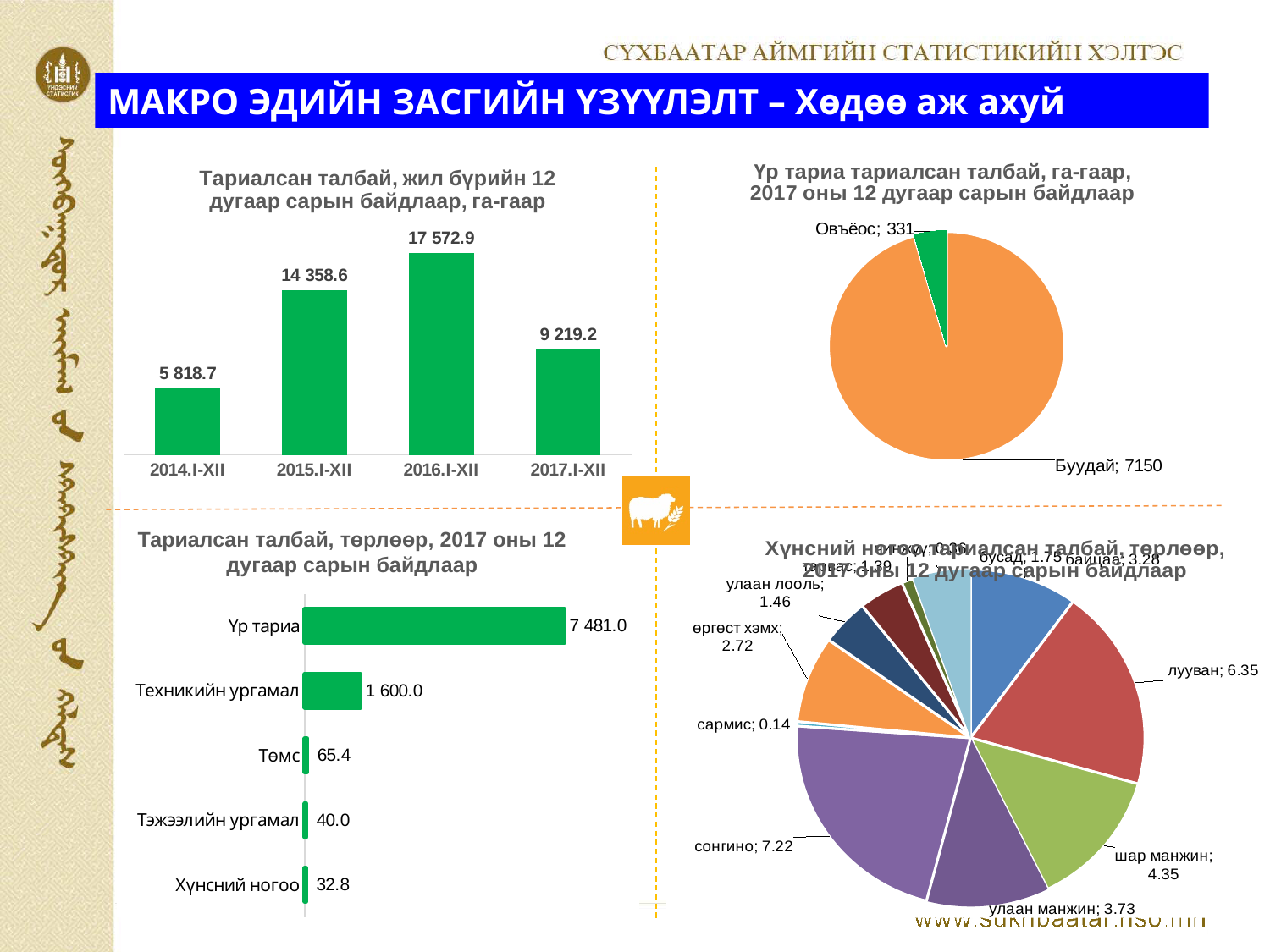
In the bottom-left bar chart 'Тариалсан талбай, төрлөөр, 2017 оны 12 дугаар сарын байдлаар', what is the difference between Төмс and Тэжээлийн ургамал? 25.4 In the bottom-left bar chart 'Тариалсан талбай, төрлөөр, 2017 оны 12 дугаар сарын байдлаар', which category has the highest value? Үр тариа In the top-right pie chart 'Үр тариа тариалсан талбай, га-гаар, 2017 оны 12 дугаар сарын байдлаар', which slice is larger, Овъёос or Буудай? Буудай In the bottom-right pie chart 'Хүнсний ногоо тариалсан талбай, төрлөөр, 2017 оны 12 дугаар сарын байдлаар', what is the value for сонгино? 7.22 In the bottom-right pie chart 'Хүнсний ногоо тариалсан талбай, төрлөөр, 2017 оны 12 дугаар сарын байдлаар', which is larger, лууван or шар манжин? лууван In the top-left bar chart 'Тариалсан талбай, жил бүрийн 12 дугаар сарын байдлаар, га-гаар', which year has the lowest value? 2014.I-XII In the top-left bar chart 'Тариалсан талбай, жил бүрийн 12 дугаар сарын байдлаар, га-гаар', how many years are shown? 4 In the top-right pie chart 'Үр тариа тариалсан талбай, га-гаар, 2017 оны 12 дугаар сарын байдлаар', what is the value for Буудай? 7150 What kind of chart is the bottom-left chart 'Тариалсан талбай, төрлөөр, 2017 оны 12 дугаар сарын байдлаар'? Bar chart In the top-left bar chart 'Тариалсан талбай, жил бүрийн 12 дугаар сарын байдлаар, га-гаар', what is the value for 2016.I-XII? 17 572.9 In the bottom-left bar chart 'Тариалсан талбай, төрлөөр, 2017 оны 12 дугаар сарын байдлаар', what is the value for Техникийн ургамал? 1 600.0 In the top-left bar chart 'Тариалсан талбай, жил бүрийн 12 дугаар сарын байдлаар, га-гаар', what is the difference between the 2016.I-XII and 2017.I-XII values? 8 353.7